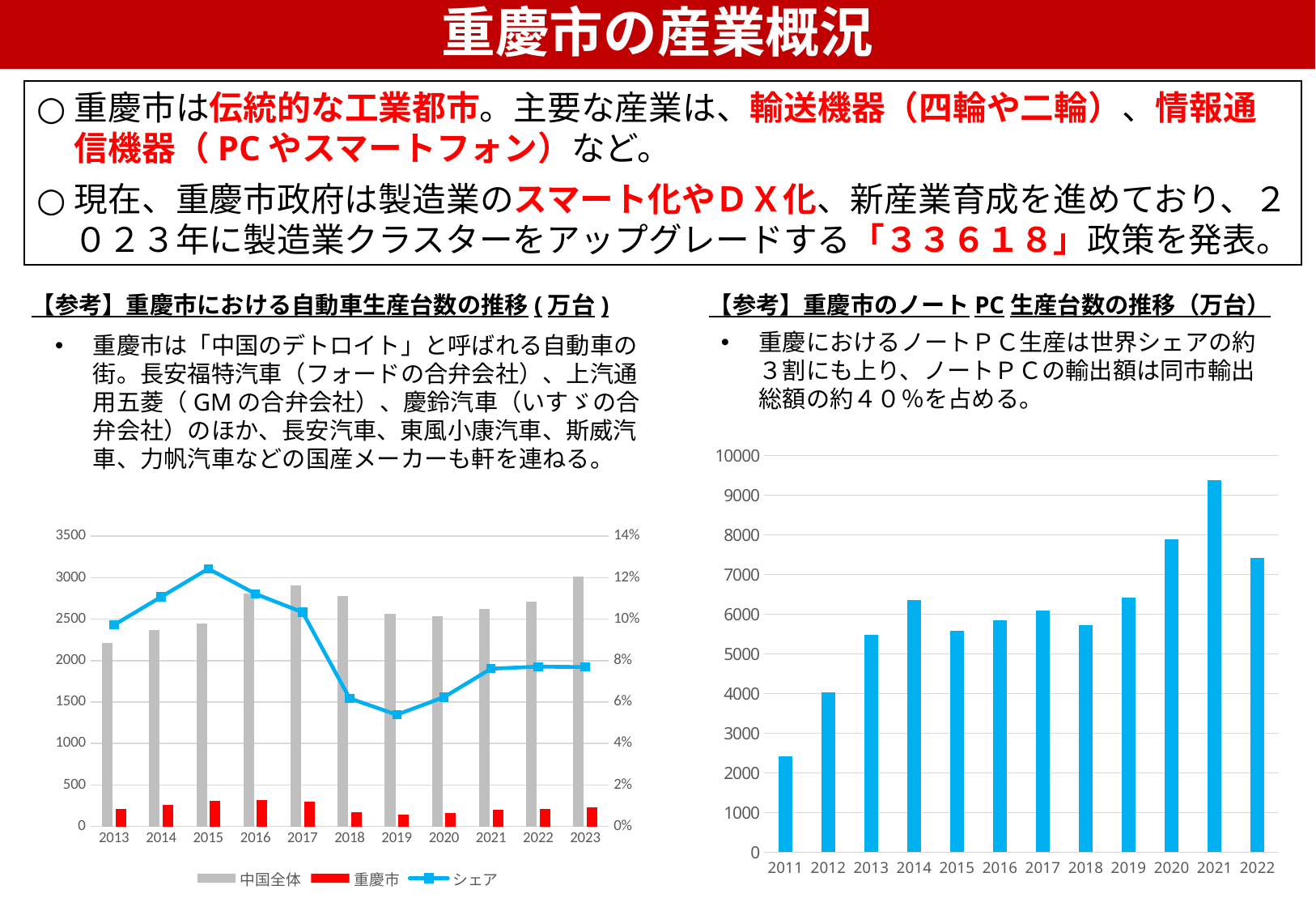
In the right-hand notebook PC production chart, is the value for 2011 greater or less than 3000? less In the left-hand automobile production chart, which year has the lowest 中国全体 (China total) bar? 2013 How many series does the legend of the left-hand automobile production chart list? 3 In the right-hand notebook PC production chart, which year has the highest value? 2021 In the right-hand notebook PC production chart, which year has the lowest value? 2011 How many years are plotted on the x axis of the right-hand notebook PC production chart? 12 In the right-hand notebook PC production chart, is the value for 2021 greater or less than 9000? greater In the right-hand notebook PC production chart, which is larger, the value for 2020 or the value for 2022? 2020 In the left-hand automobile production chart, in which year does the シェア (share) line reach its lowest point? 2019 In the left-hand automobile production chart, in which year does the シェア (share) line reach its highest point? 2015 What kind of chart is the right-hand chart showing Chongqing notebook PC production? bar chart